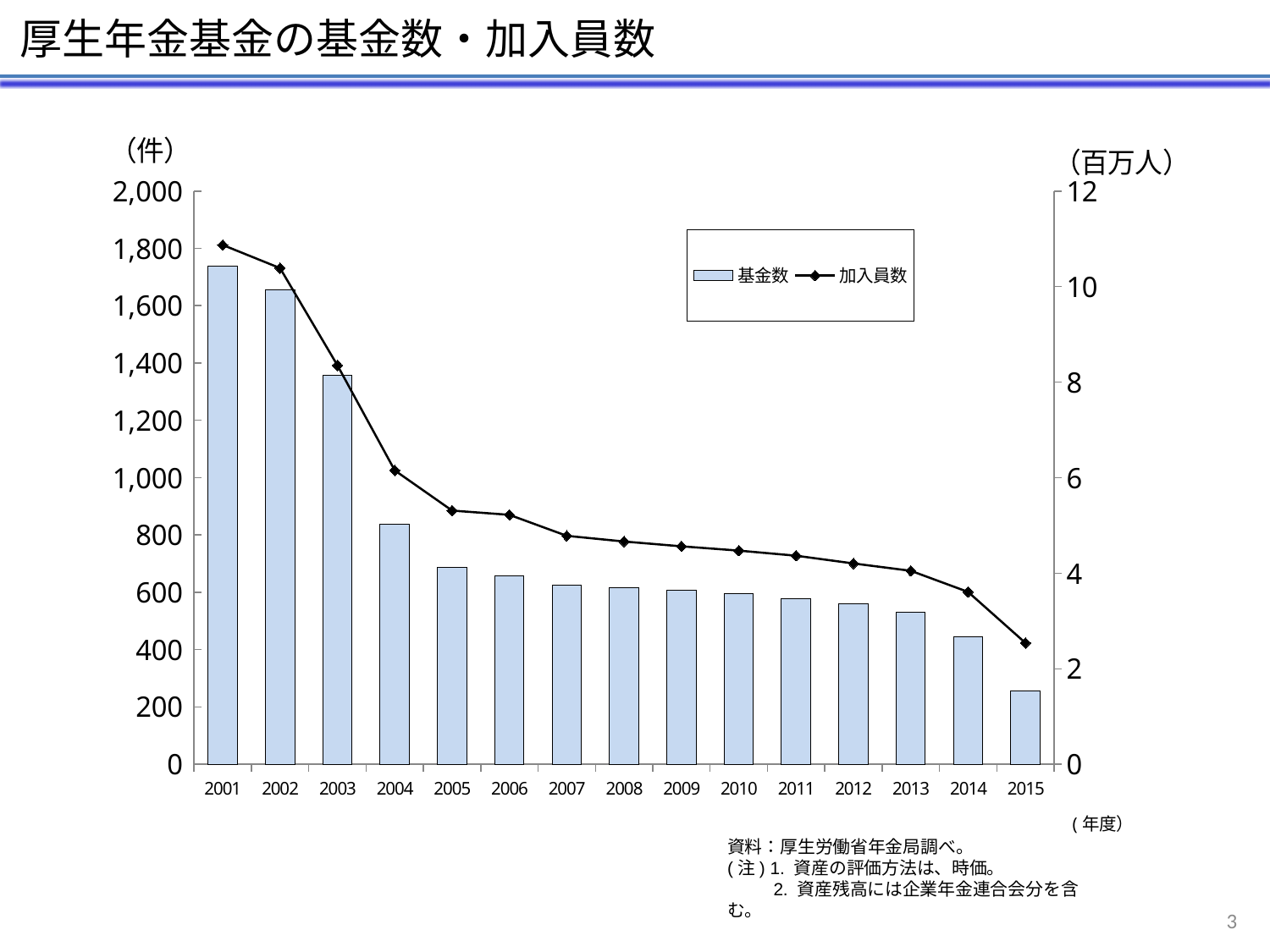
Is the value for 基金数 in 2015 greater or less than 400? less What unit is shown on the right-hand axis? 百万人 What kind of chart is shown on the slide? A combined bar and line chart Is the value for 基金数 in 2004 greater or less than 1,000? less How many series does the legend list? 2 How many years are shown along the x axis? 15 Do the values for 加入員数 rise or fall from 2001 to 2015? Fall Which year has the highest value for 基金数? 2001 Is the value for 加入員数 in 2001 greater or less than 10? greater Which is larger, the value for 基金数 in 2002 or in 2010? 2002 Which year has the lowest value for 基金数? 2015